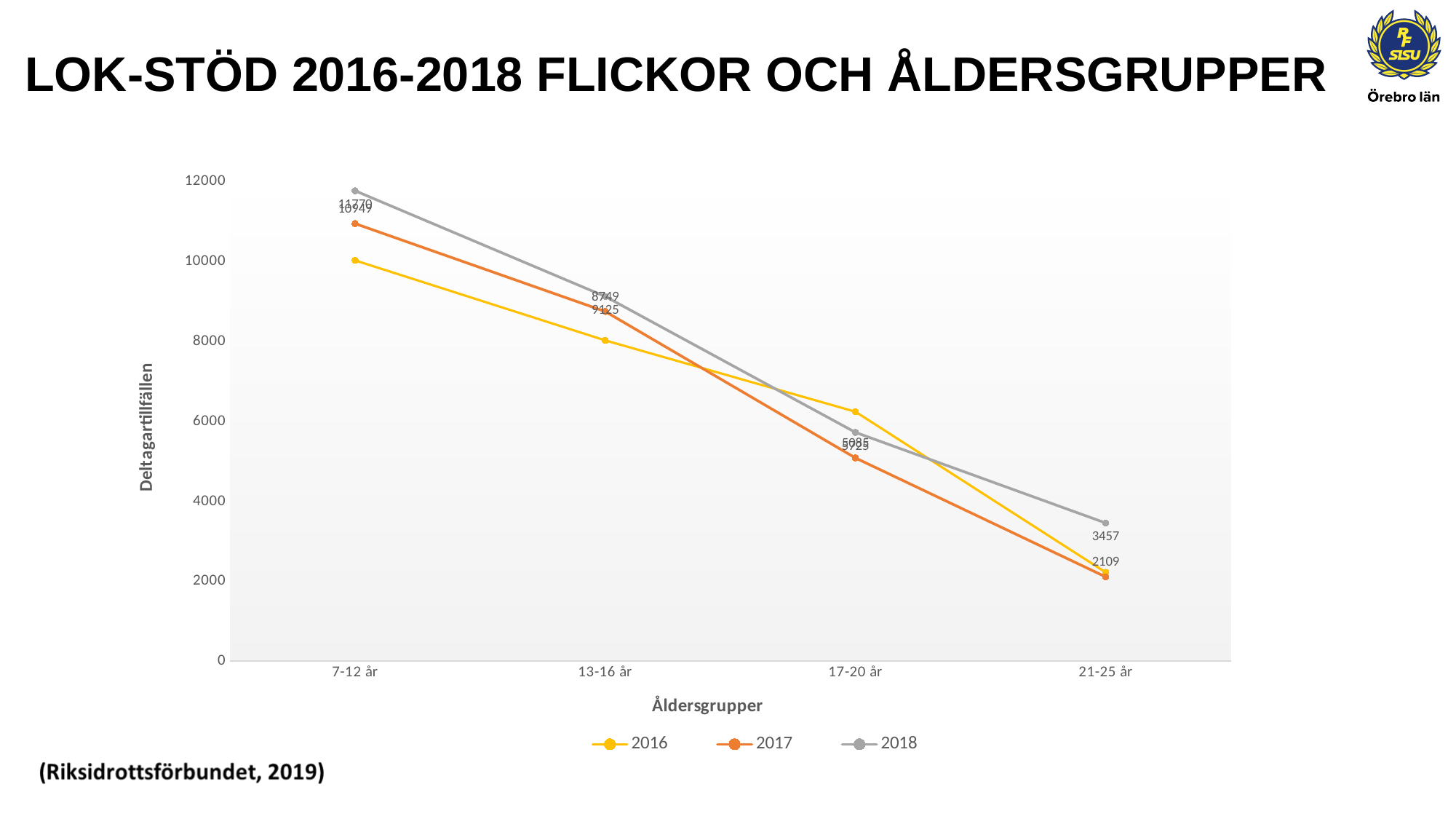
Which series has the highest value for the 7-12 år age group? 2018 Do the values for the 2018 series rise or fall from 7-12 år to 21-25 år? fall Is the value for 2018 in the 21-25 år age group greater or less than 4000? less For the 21-25 år age group, which is larger: the value for 2018 or the value for 2017? 2018 Is the value for 2016 in the 7-12 år age group greater or less than 8000? greater Is the value for 2017 in the 17-20 år age group greater or less than 4000? greater For the 17-20 år age group, which is larger: the value for 2016 or the value for 2017? 2016 What is the title of the y axis? Deltagartillfällen How many series does the legend list? 3 How many age groups are shown on the x axis? 4 What kind of chart is shown on the slide? line chart What is the value for 2018 in the 21-25 år age group? 3457